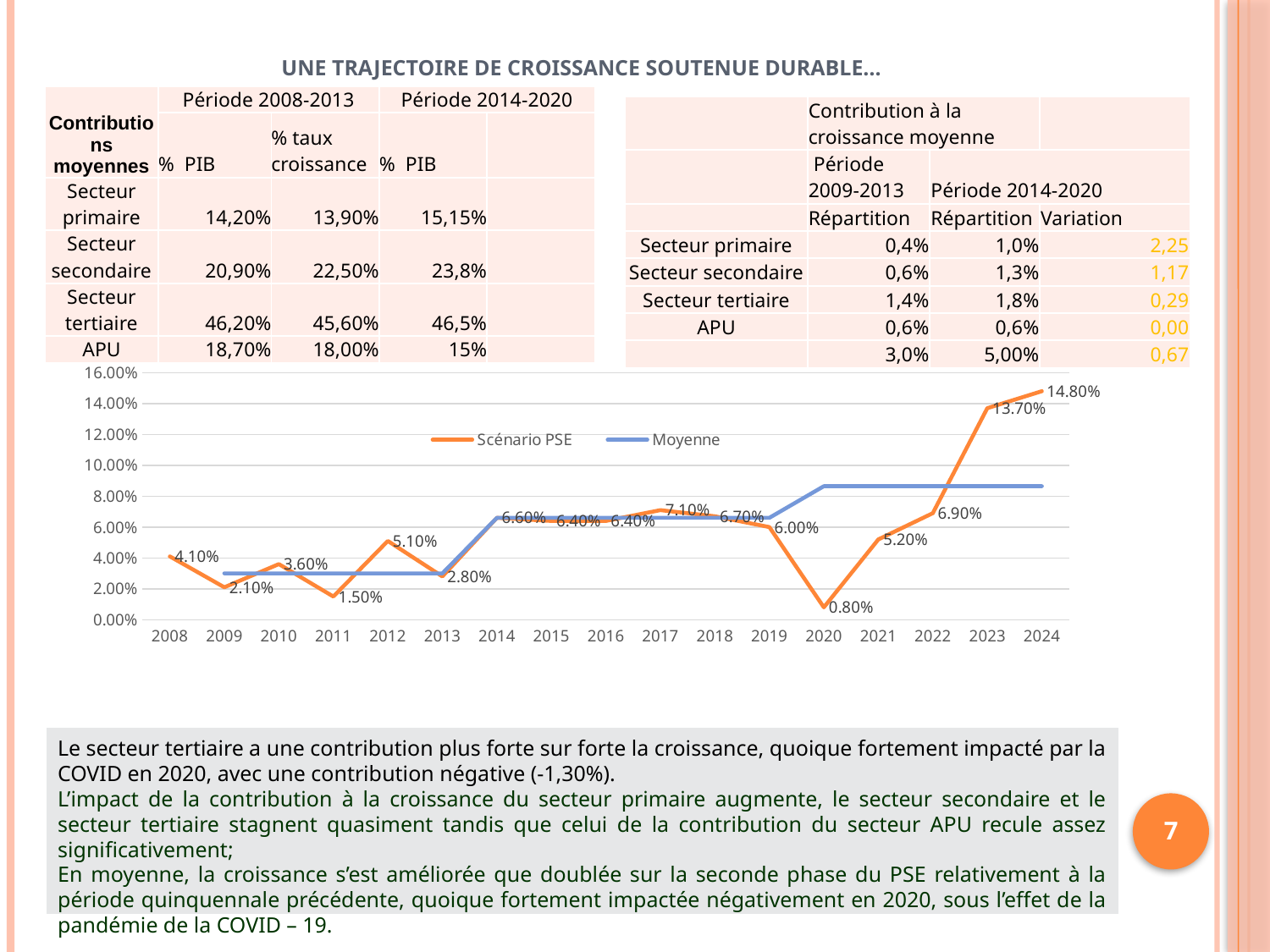
In which year is the Scénario PSE value highest? 2024 Is the Moyenne value for 2010 greater or less than 4.00%? less In which year is the Scénario PSE value lowest? 2020 Is the Moyenne value for 2022 greater or less than 8.00%? greater What kind of chart is shown on the slide? Line chart How many series does the chart legend list? 2 What is the Scénario PSE value for 2024? 14.80% How many years are shown on the x axis of the chart? 17 Which year has the larger Scénario PSE value, 2017 or 2019? 2017 What is the Scénario PSE value for 2020? 0.80% What is the difference between the Scénario PSE values for 2024 and 2023? 1.10% What is the Scénario PSE value for 2012? 5.10%